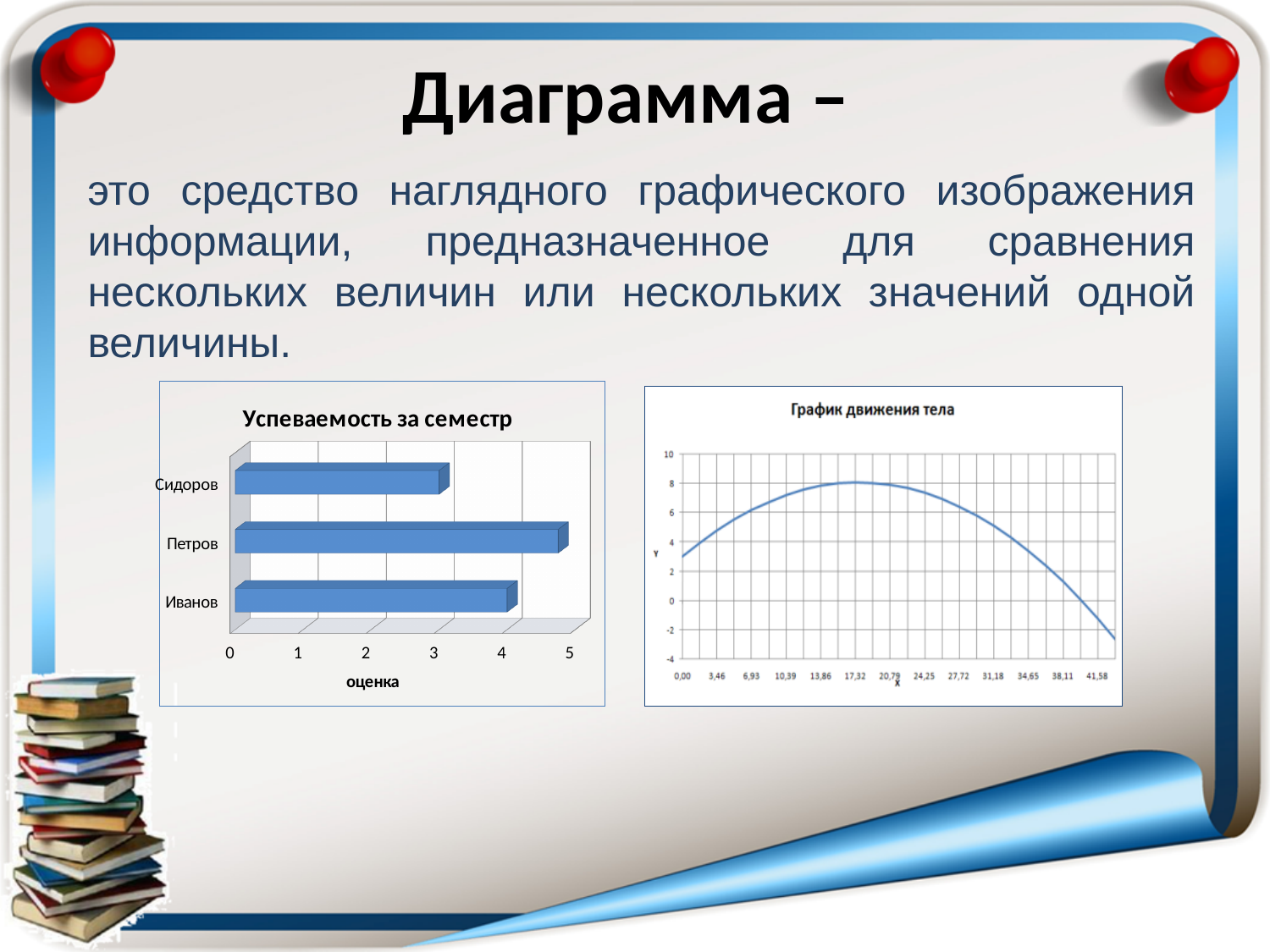
In the chart "Успеваемость за семестр", is the value for Петров greater or less than 4? greater In the chart "Успеваемость за семестр", which student has the highest value? Петров In the chart "Успеваемость за семестр", what is the title of the horizontal axis? оценка In the chart "Успеваемость за семестр", who has the larger value, Иванов or Сидоров? Иванов What kind of chart is the chart titled "Успеваемость за семестр"? bar chart In the chart "График движения тела", how does the line behave as x increases from 0,00 to 41,58? rises, then falls What kind of chart is the chart titled "График движения тела"? line chart In the chart "График движения тела", is the value of Y at x = 41,58 greater or less than 0? less In the chart "Успеваемость за семестр", how many students (categories) are shown? 3 In the chart "Успеваемость за семестр", which student has the lowest value? Сидоров In the chart "Успеваемость за семестр", is the value for Сидоров greater or less than 4? less What is the title of the chart on the right side of the slide? График движения тела